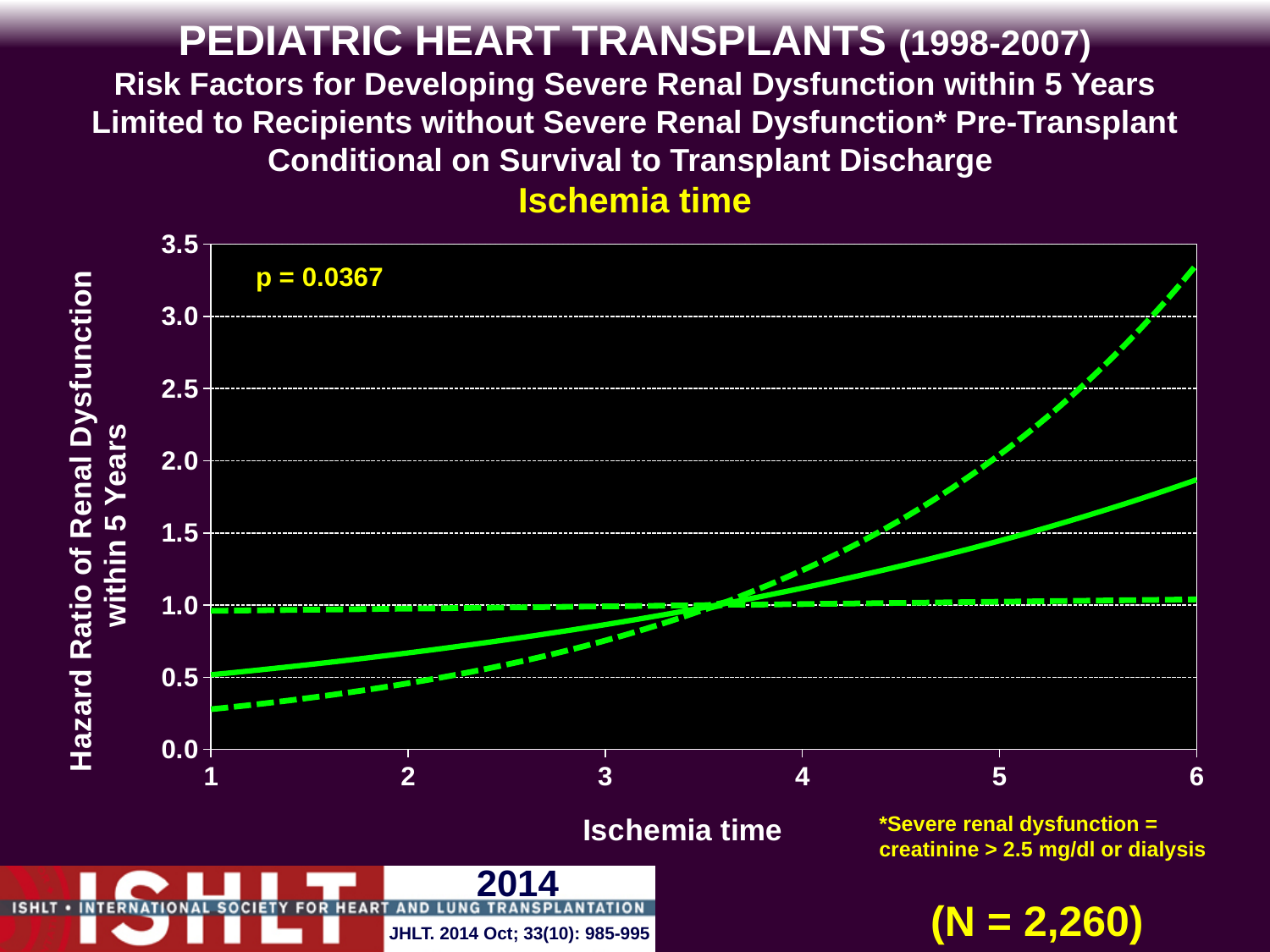
Is the value of the upper dashed line at ischemia time 4 greater or less than 1.0? greater Does the solid hazard ratio line rise or fall as ischemia time increases from 1 to 6? rise Is the value of the solid hazard ratio line at ischemia time 6 greater or less than 1.5? greater What kind of chart is shown on the slide? line chart Is the value of the solid hazard ratio line at ischemia time 6 greater or less than 2.0? less What is the label of the x axis of the chart? Ischemia time How many lines are plotted on the chart? 3 What is the highest tick value shown on the y axis? 3.5 What p-value is printed on the chart? p = 0.0367